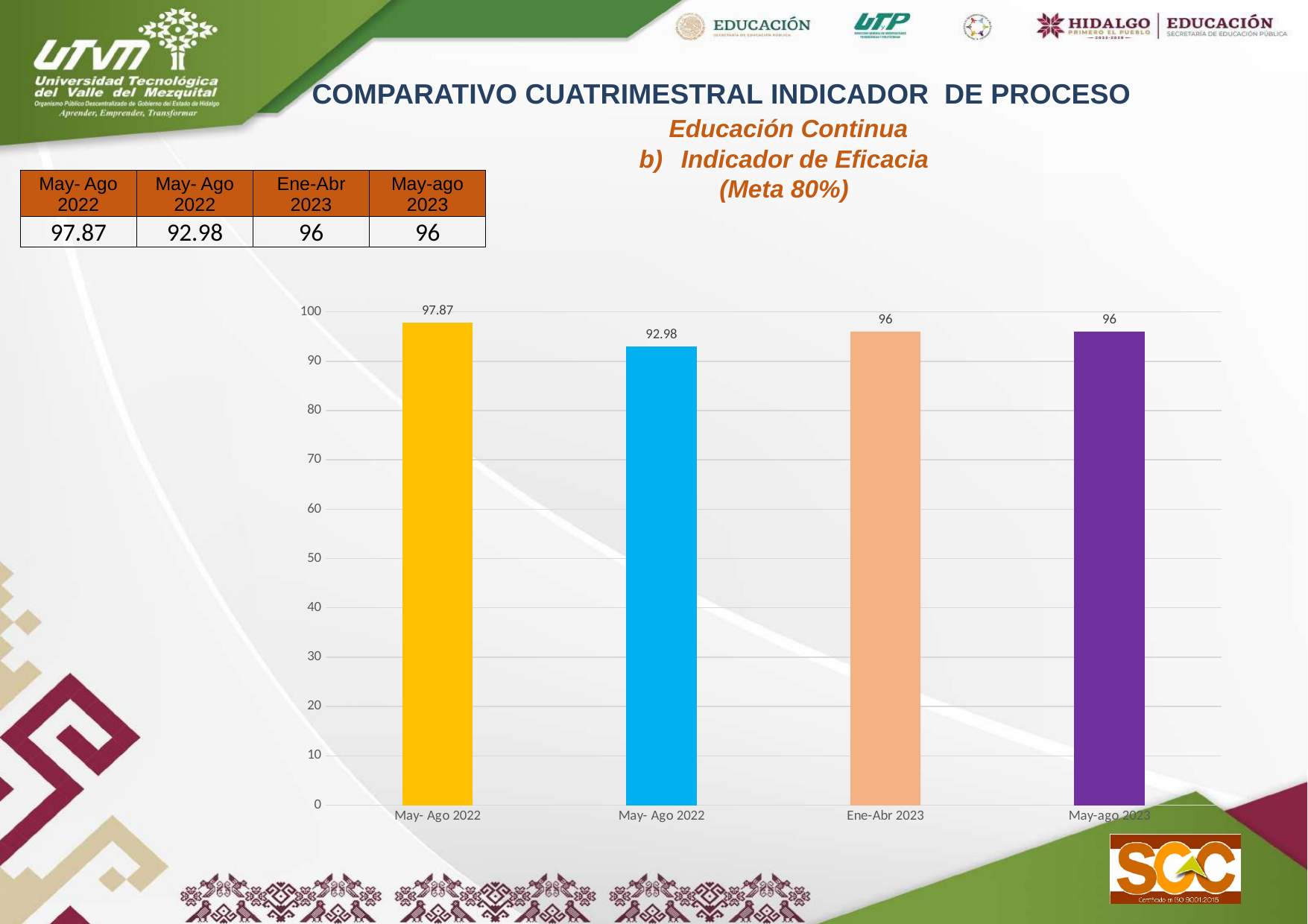
What is the value shown on the first (leftmost) bar, labelled May- Ago 2022? 97.87 How many bars are plotted in the chart? 4 Which bar has the highest value? The first (leftmost) May- Ago 2022 bar, 97.87 What is the value for May-ago 2023? 96 What is the value shown on the second bar from the left, labelled May- Ago 2022? 92.98 What is the difference between the highest value (97.87) and the lowest value (92.98)? 4.89 What is the value for Ene-Abr 2023? 96 Which is larger, the value for Ene-Abr 2023 or the value of the second bar (92.98)? Ene-Abr 2023 What is the difference between the first bar (97.87) and the Ene-Abr 2023 bar (96)? 1.87 What type of chart is shown on the slide? Bar chart Is the value for May-ago 2023 greater or less than 80? greater Which bar has the lowest value? The second May- Ago 2022 bar, 92.98